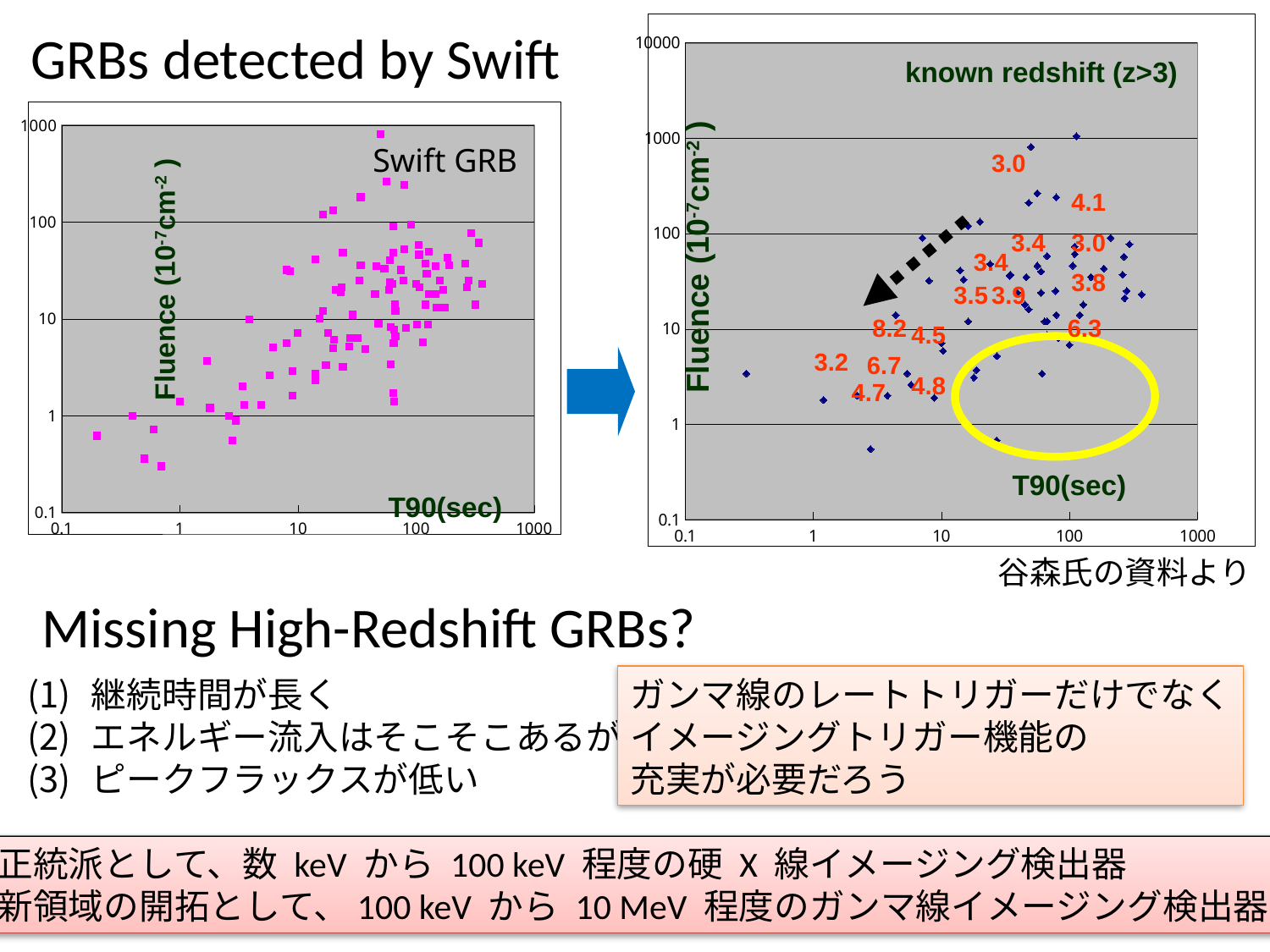
In the right chart, what is the label of the x axis? T90(sec) In the left chart, what is the highest value shown on the y axis? 1000 What kind of chart is the left chart titled 'Swift GRB'? scatter plot What kind of chart is the right chart titled 'known redshift (z>3)'? scatter plot In the right chart, what is the highest value shown on the y axis? 10000 In the right chart, is the fluence of the point labeled 8.2 greater or less than 100? less In the right chart, how many redshift value labels are printed next to the data points? 15 In the right chart, what is the smallest redshift value printed next to a data point? 3.0 In the right chart, what is the lowest value shown on the x axis? 0.1 In the left chart, is the fluence of the highest data point greater or less than 100? greater In the right chart, what is the largest redshift value printed next to a data point? 8.2 In the left chart, what is the label of the y axis? Fluence (10^-7 cm^-2)